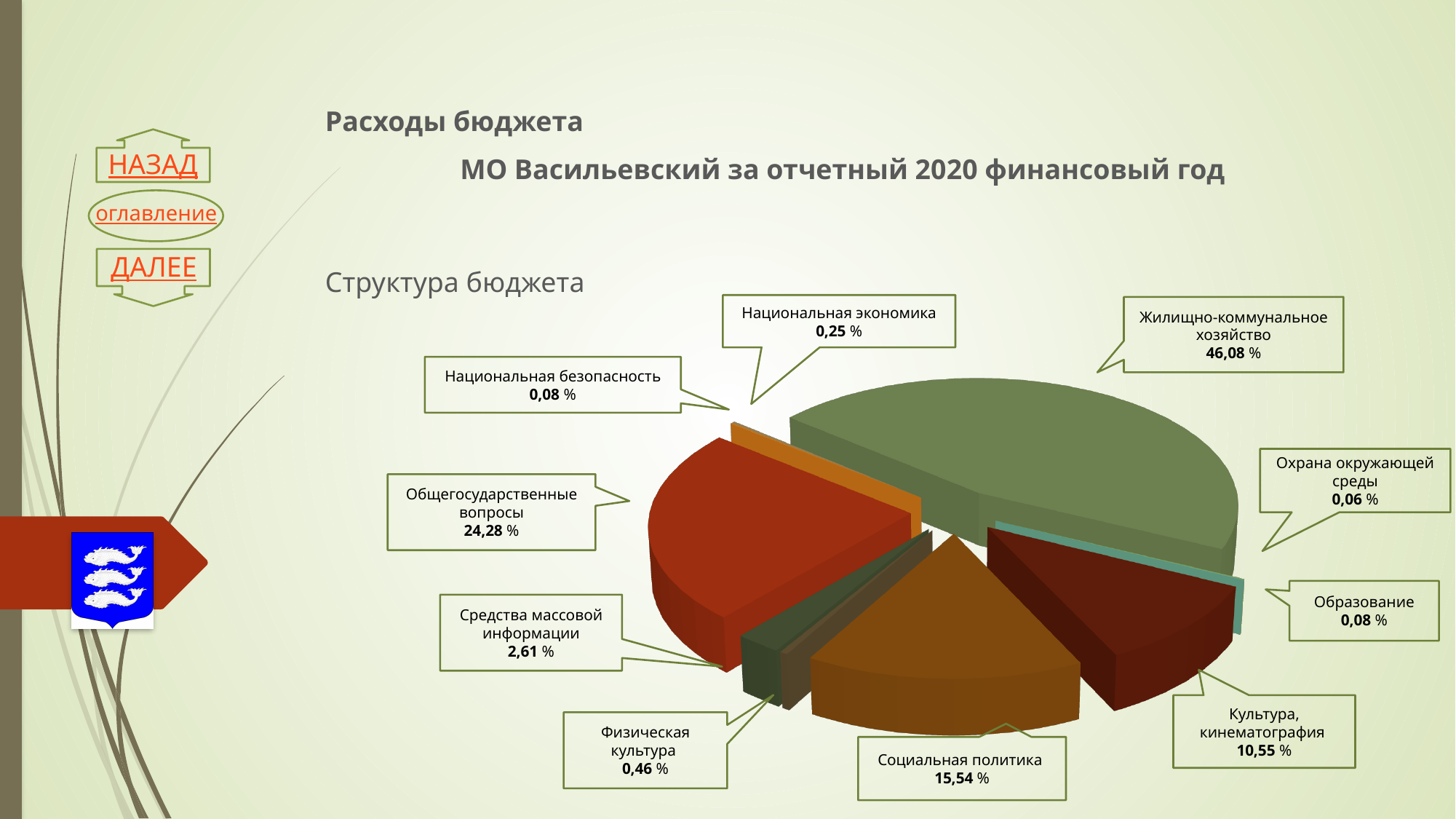
What is the difference between Жилищно-коммунальное хозяйство and Общегосударственные вопросы? 21,80 % What is the value for Жилищно-коммунальное хозяйство? 46,08 % Which category has the smallest share of the pie? Охрана окружающей среды What is the value for Социальная политика? 15,54 % What is the heading shown above the pie chart? Структура бюджета What is the value for Средства массовой информации? 2,61 % How many categories are shown in the pie chart? 10 Which category has the largest share of the pie? Жилищно-коммунальное хозяйство What kind of chart is shown on the slide? pie chart What is the value for Общегосударственные вопросы? 24,28 % Which is larger, Социальная политика or Культура, кинематография? Социальная политика What is the difference between Социальная политика and Культура, кинематография? 4,99 %